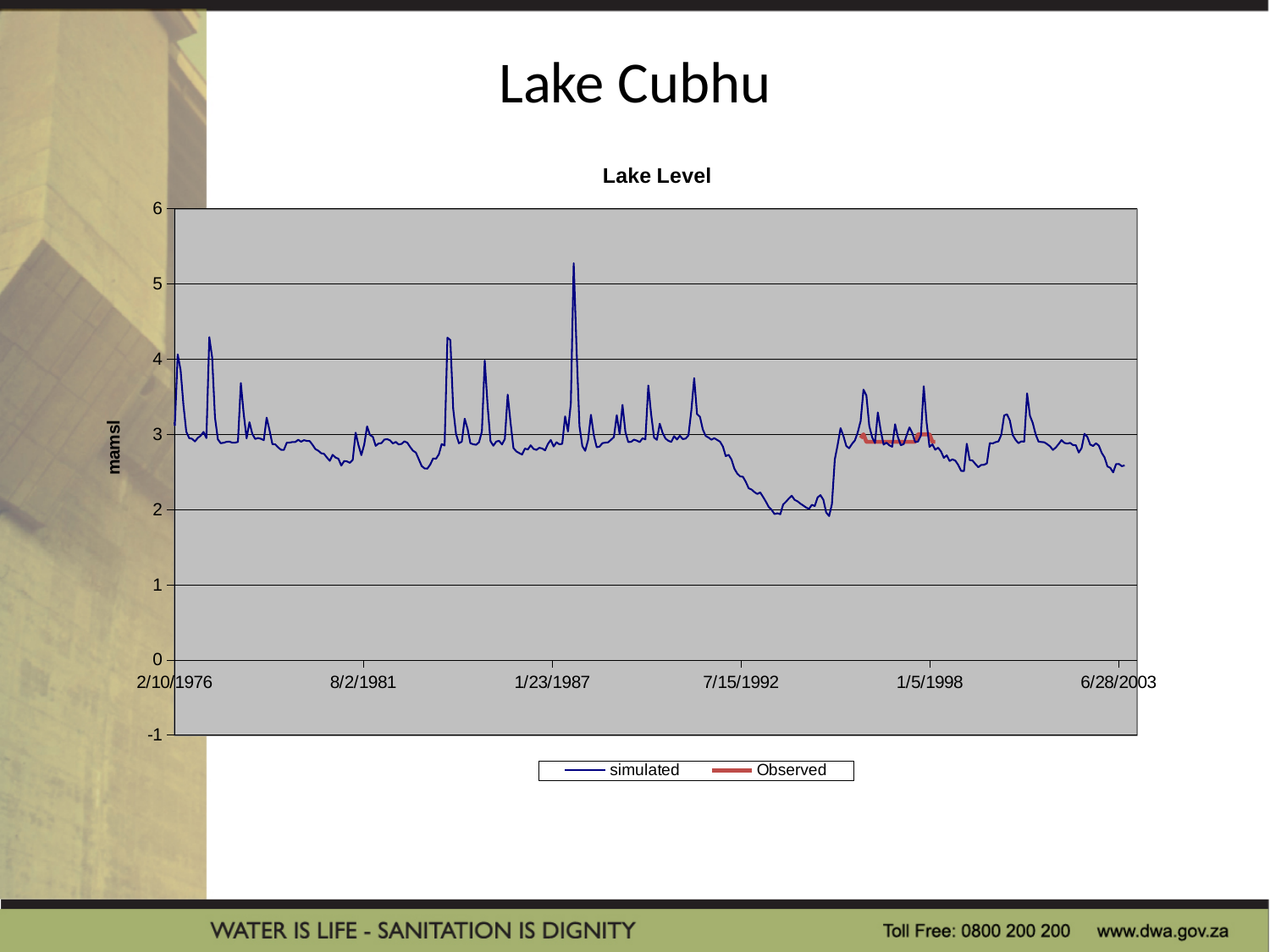
Do the simulated values rise or fall in the period just after 7/15/1992? fall Are the Observed values greater or less than 2? greater Is the highest peak of the simulated series (near 1987) greater or less than 5? greater What is the first date label on the x axis of the Lake Level chart? 2/10/1976 How many series does the legend of the Lake Level chart list? 2 Is the lowest simulated value, reached between 7/15/1992 and 1/5/1998, greater or less than 3? less What is the title of the chart on the slide? Lake Level What kind of chart is shown on the slide? line chart Which series reaches the highest value on the chart, simulated or Observed? simulated What is the label on the vertical axis of the Lake Level chart? mamsl How many date labels are shown on the x axis of the Lake Level chart? 6